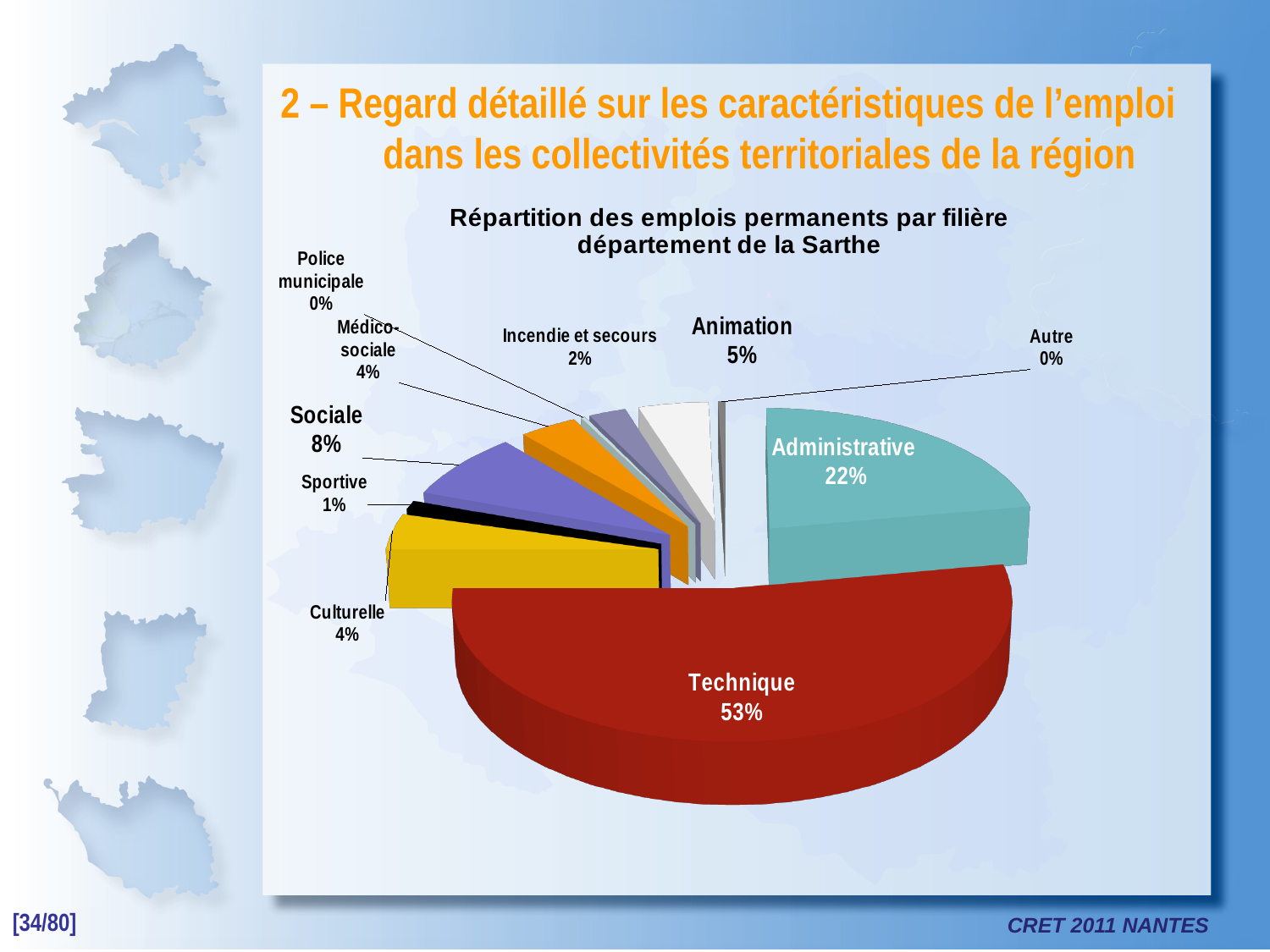
What value is given for Incendie et secours? 2% How many categories (slices) are labelled on the pie chart? 10 What is the difference in percentage points between the Technique and Administrative slices? 31 Which is larger, the Sociale slice or the Animation slice? Sociale What percentage is shown for Animation? 5% Which filière has the largest share of the pie? Technique What percentage is shown for the Administrative slice? 22% What share of permanent jobs does the Technique filière hold? 53% What is the title of the chart? Répartition des emplois permanents par filière département de la Sarthe What kind of chart is shown on the slide? Pie chart What value is labelled for the Sociale slice? 8% What is the combined share of the Culturelle and Médico-sociale slices? 8%